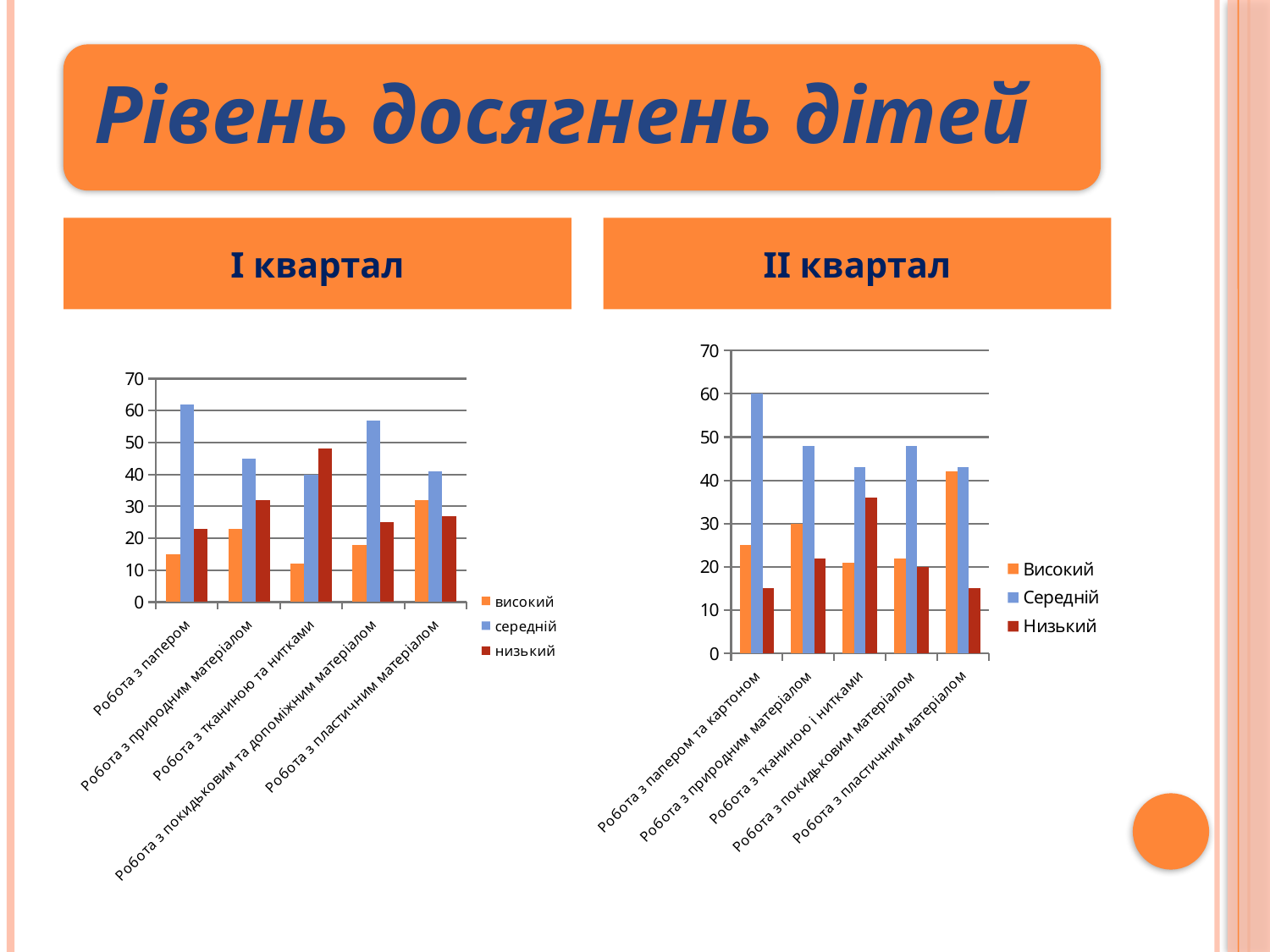
On the І квартал chart, what are the three legend entries? високий, середній, низький On the І квартал chart, how many categories are shown on the x axis? 5 On the ІІ квартал chart, how many series does the legend list? 3 On the І квартал chart, which category has the lowest високий value? Робота з тканиною та нитками On the ІІ квартал chart, is the Високий value for Робота з пластичним матеріалом greater or less than 30? greater On the ІІ квартал chart, what is the Середній value for Робота з папером та картоном? 60 On the І квартал chart, is the середній value for Робота з покидьковим та допоміжним матеріалом greater or less than 50? greater On the І квартал chart, which category has the highest середній value? Робота з папером On the І квартал chart, is the низький value for Робота з тканиною та нитками greater or less than 40? greater On the ІІ квартал chart, which category has the highest Низький value? Робота з тканиною і нитками On the ІІ квартал chart, for Робота з папером та картоном, which is larger: Середній or Низький? Середній On the І квартал chart, what kind of chart is shown? bar chart